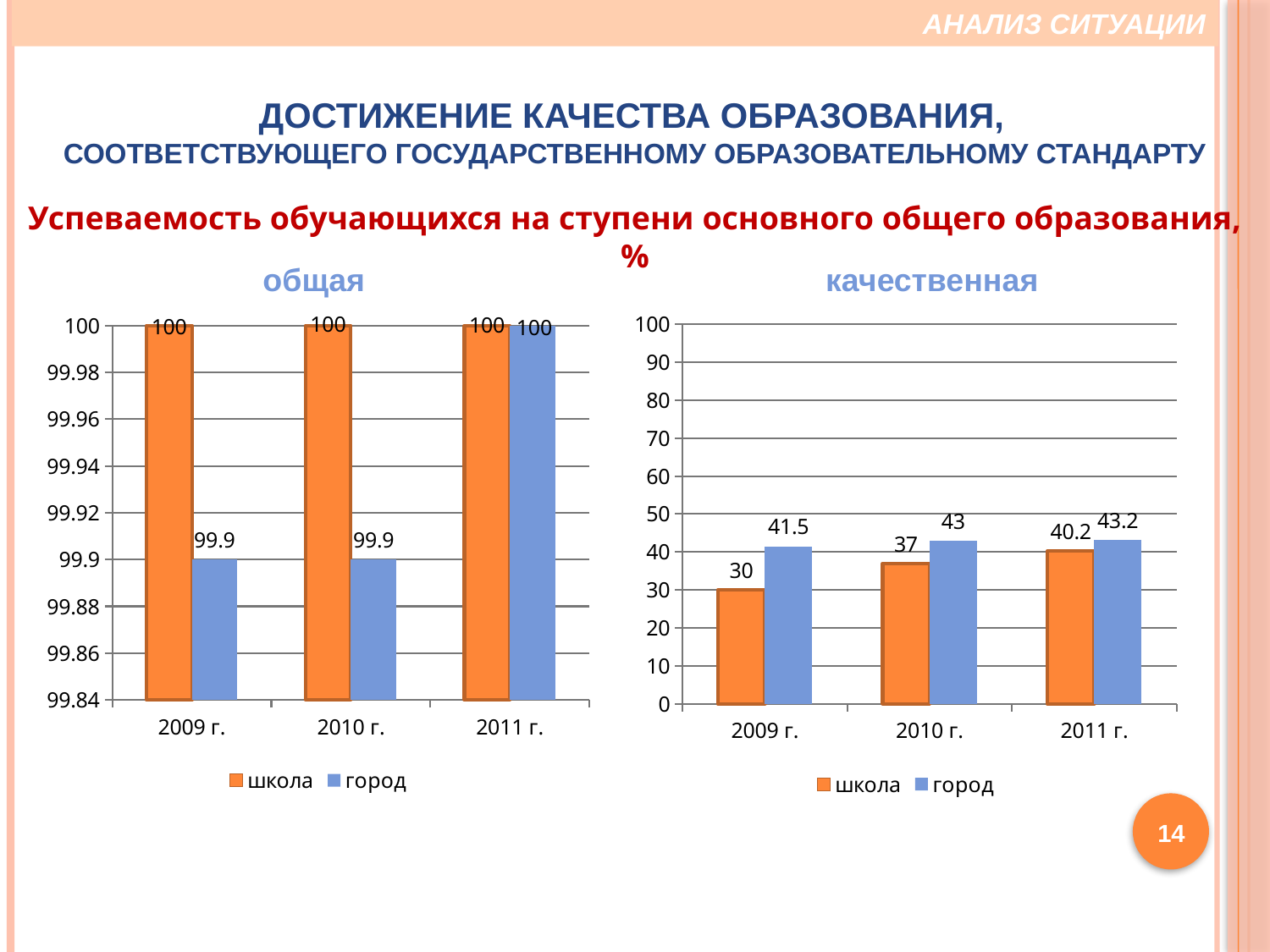
In the 'качественная' chart, which year has the lowest value for 'школа'? 2009 г. In the 'общая' chart, what is the value for 'город' in 2009 г.? 99.9 In the 'качественная' chart, which is larger in 2010 г., 'школа' or 'город'? город In the 'качественная' chart, which year has the highest value for 'город'? 2011 г. In the 'общая' chart, what is the value for 'школа' in 2010 г.? 100 In the 'качественная' chart, what is the value for 'город' in 2011 г.? 43.2 In the 'качественная' chart, what is the difference between 'город' and 'школа' in 2009 г.? 11.5 In the 'качественная' chart, what is the value for 'школа' in 2009 г.? 30 How many series does the legend of the 'качественная' chart list? 2 In the 'общая' chart, what is the value for 'город' in 2011 г.? 100 In the 'качественная' chart, do the values for 'школа' rise or fall from 2009 г. to 2011 г.? rise What kind of chart is the 'общая' chart? bar chart